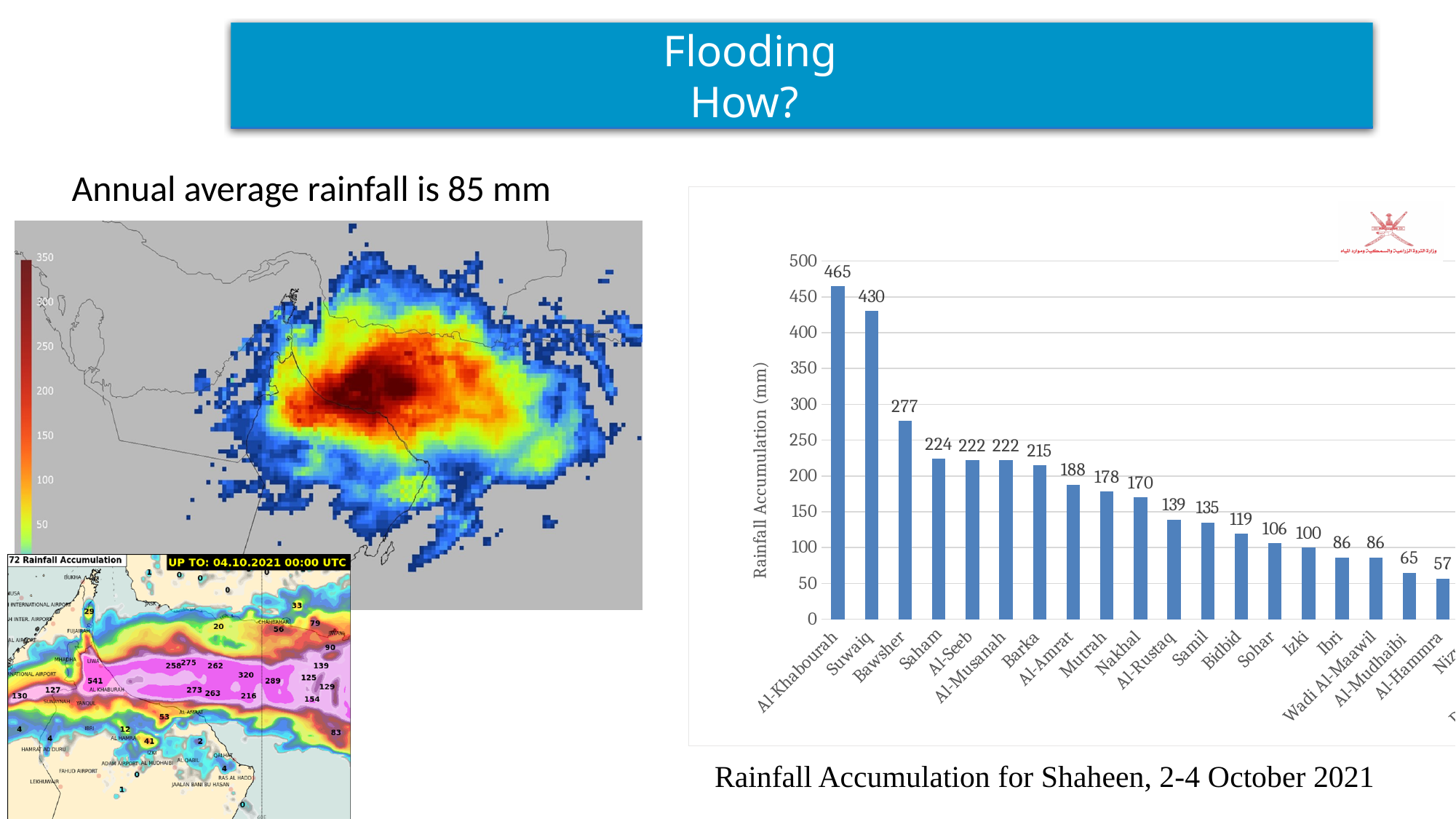
What is the rainfall accumulation for Bawsher? 277 Which location has the highest rainfall accumulation? Al-Khabourah Which has a larger rainfall accumulation, Mutrah or Al-Rustaq? Mutrah What is the caption of the bar chart? Rainfall Accumulation for Shaheen, 2-4 October 2021 Which has a larger rainfall accumulation, Bidbid or Izki? Bidbid What is the rainfall accumulation for Sohar? 106 What is the rainfall accumulation for Nakhal? 170 What is the difference in rainfall accumulation between Saham and Barka? 9 What is the difference in rainfall accumulation between Al-Khabourah and Suwaiq? 35 What kind of chart is used to show the rainfall accumulation? Bar chart What is the label of the vertical axis of the bar chart? Rainfall Accumulation (mm) What is the rainfall accumulation for Al-Khabourah? 465